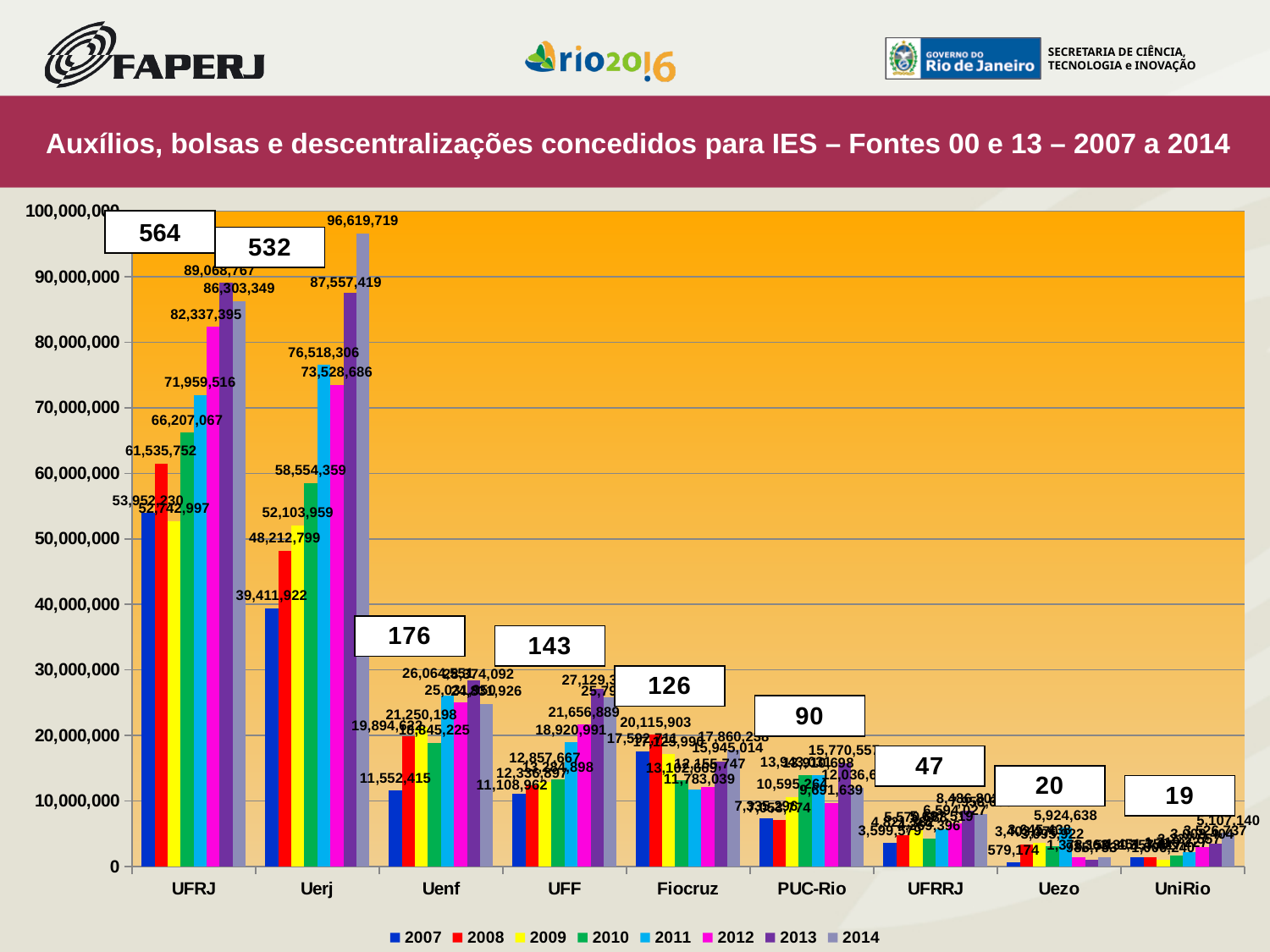
What is the value for Uerj in 2014? 96,619,719 What is the value for UFRJ in 2011? 71,959,516 Between 2007 and 2010, do the values for Uerj rise or fall? rise What is the value for Uezo in 2007? 579,174 How many years does the chart legend list? 8 What is the value for Uerj in 2007? 39,411,922 Which is larger, the 2008 value for UFRJ or the 2008 value for Uerj? UFRJ Is the value for UFF in 2013 greater or less than 20,000,000? greater Which institution has the tallest bar in the chart? Uerj What is the difference between the Uerj values for 2014 and 2013? 9,062,300 What kind of chart is shown on the slide? bar chart How many institutions are shown along the x axis of the chart? 9